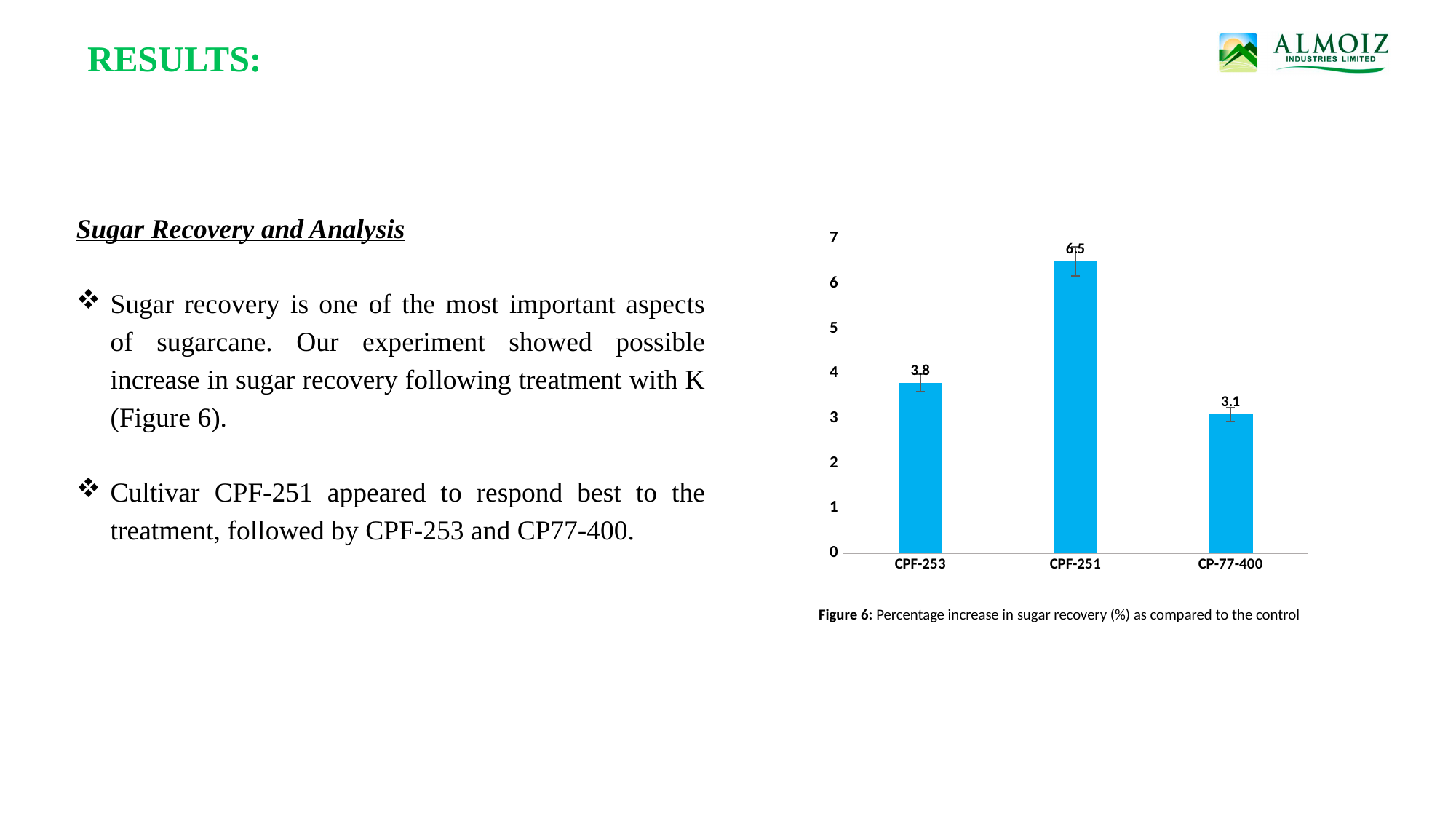
Which cultivar has the highest percentage increase in sugar recovery? CPF-251 How many cultivars are shown on the chart? 3 What kind of chart is shown on the slide? bar chart What is the difference between the values for CPF-253 and CP-77-400? 0.7 What is the caption of the figure below the chart? Figure 6: Percentage increase in sugar recovery (%) as compared to the control What is the value for CPF-253? 3.8 Is the value for CPF-251 greater or less than 6? greater What is the value for CPF-251? 6.5 What is the difference between the values for CPF-251 and CPF-253? 2.7 What is the value for CP-77-400? 3.1 Which is larger, the value for CPF-253 or the value for CP-77-400? CPF-253 Which cultivar has the lowest percentage increase in sugar recovery? CP-77-400